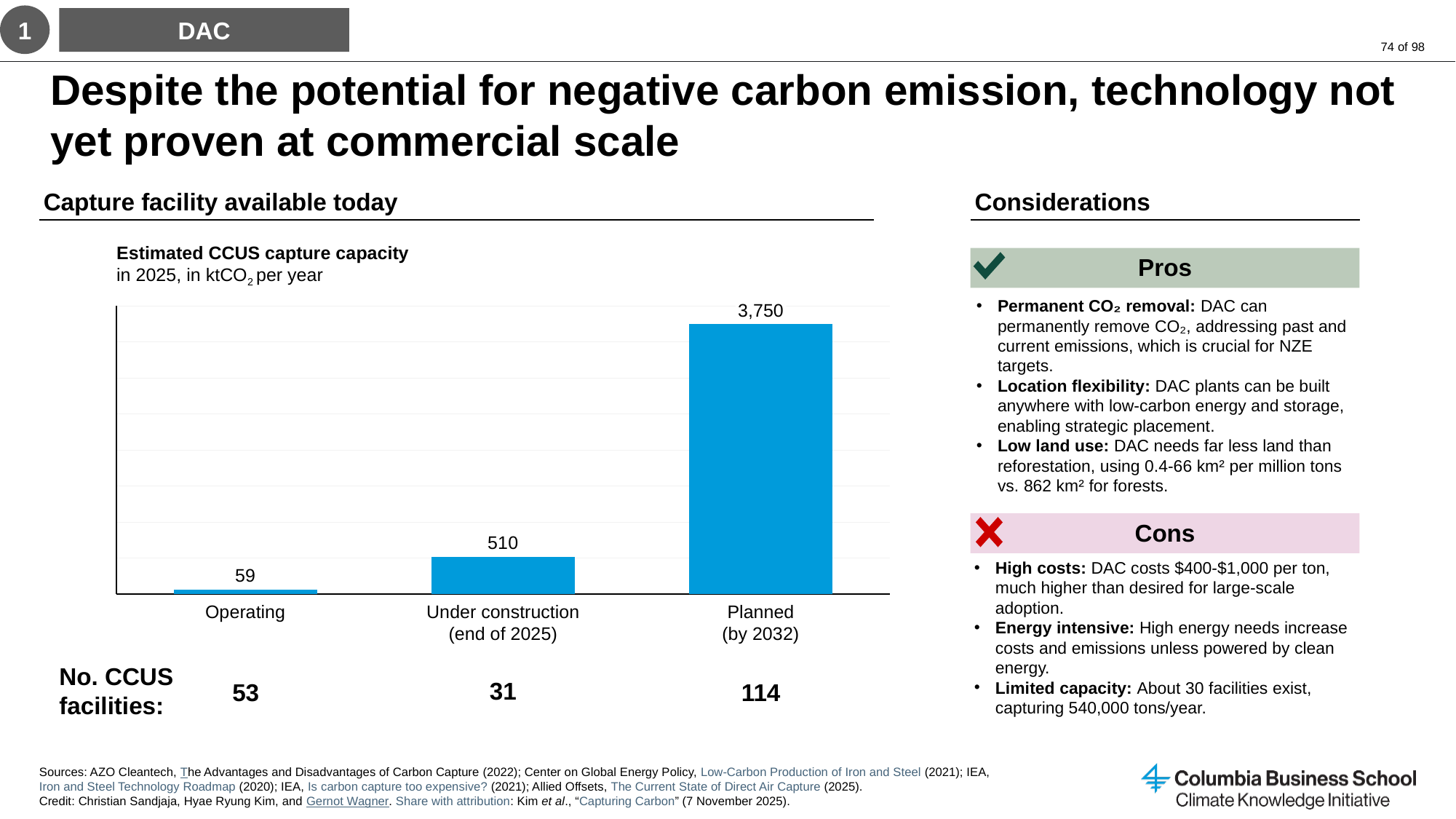
What is the difference in capture capacity between Under construction (end of 2025) and Operating? 451 What kind of chart is used to show estimated CCUS capture capacity? Bar chart What is the estimated CCUS capture capacity for Operating facilities? 59 Which category has the highest estimated CCUS capture capacity? Planned (by 2032) Which category has the lowest estimated CCUS capture capacity? Operating How many categories are shown in the chart? 3 What is the estimated CCUS capture capacity for Planned (by 2032)? 3,750 Do the capture capacity values rise or fall from Operating to Planned (by 2032)? Rise What is the difference in capture capacity between Planned (by 2032) and Under construction (end of 2025)? 3,240 Which has a larger capture capacity, Operating or Under construction (end of 2025)? Under construction (end of 2025) What is the estimated CCUS capture capacity for Under construction (end of 2025)? 510 What unit is the estimated CCUS capture capacity measured in, according to the chart title? ktCO2 per year